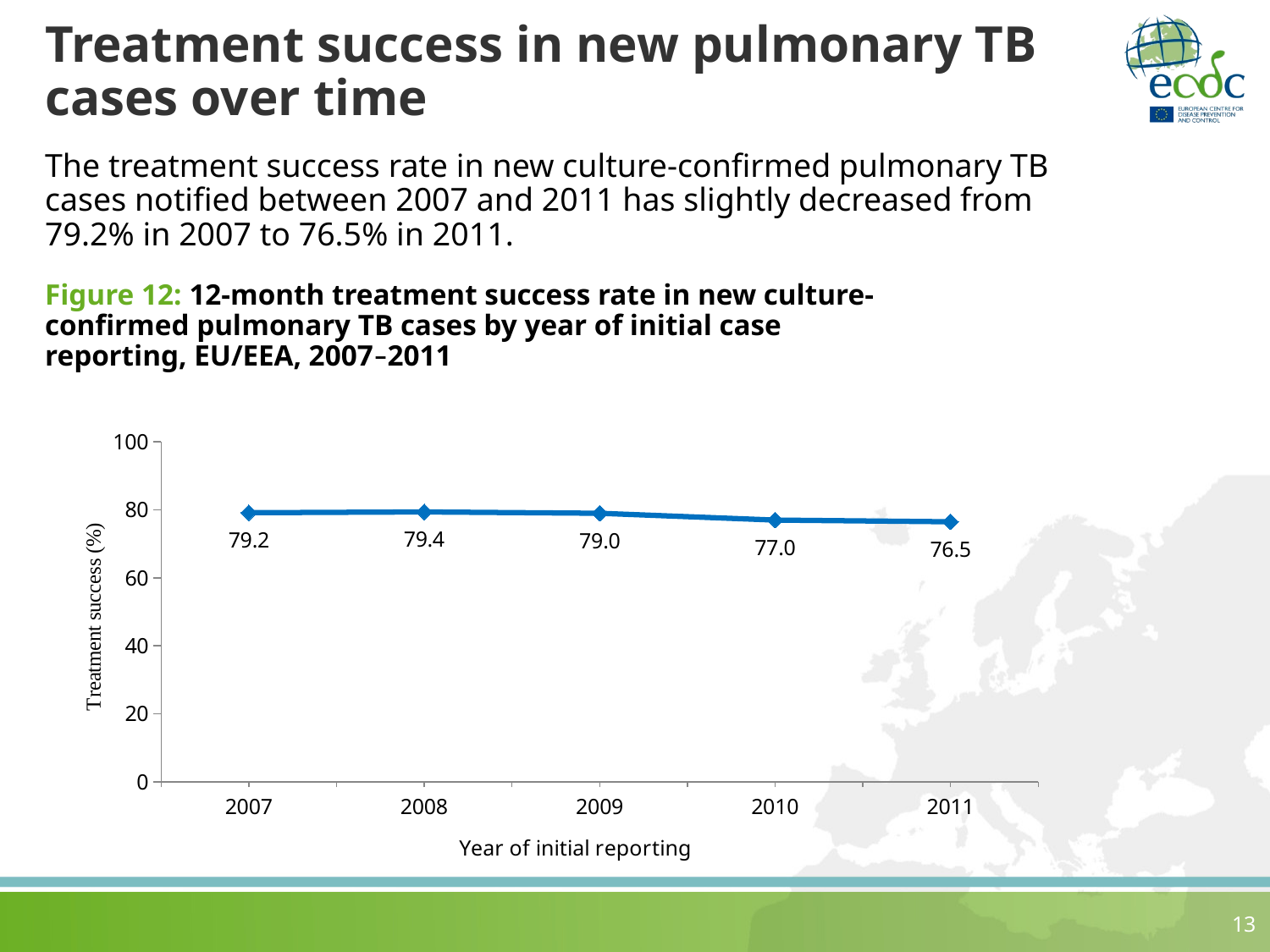
Which year has the lowest treatment success rate? 2011 Is the treatment success rate for 2010 greater or less than 80? less What is the treatment success rate for 2007? 79.2 What kind of chart is shown on the slide? line chart What is the treatment success rate for 2011? 76.5 Which year has the highest treatment success rate? 2008 How many years are plotted on the chart? 5 Which year has a higher treatment success rate, 2009 or 2010? 2009 What is the difference between the treatment success rate in 2007 and in 2011? 2.7 What is the label of the x axis? Year of initial reporting What is the treatment success rate for 2009? 79.0 Does the treatment success rate rise or fall from 2008 to 2011? fall